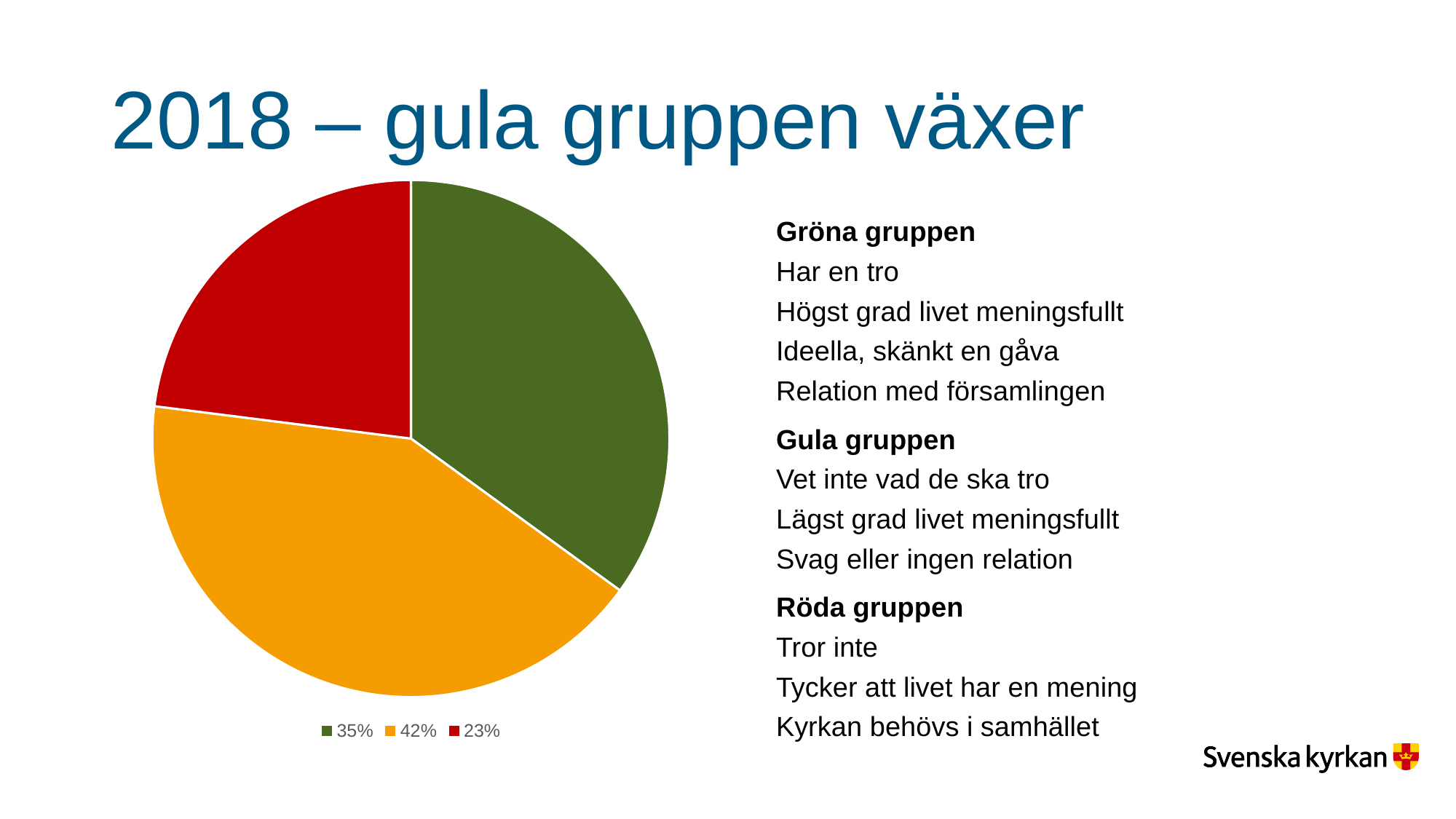
How many entries does the legend of the pie chart list? 3 What share of the pie does the yellow (orange) slice represent? 42% Which slice is larger, the green one or the red one? green What share of the pie does the green slice represent? 35% Which colour slice is the smallest in the pie chart? red (23%) Which colour slice is the largest in the pie chart? yellow (42%) What share of the pie does the red slice represent? 23% What is the title of the slide containing the pie chart? 2018 – gula gruppen växer How many slices does the pie chart have? 3 What kind of chart is shown on the slide? pie chart What is the difference in percentage points between the green slice and the red slice? 12 percentage points What is the difference in percentage points between the yellow slice and the green slice? 7 percentage points